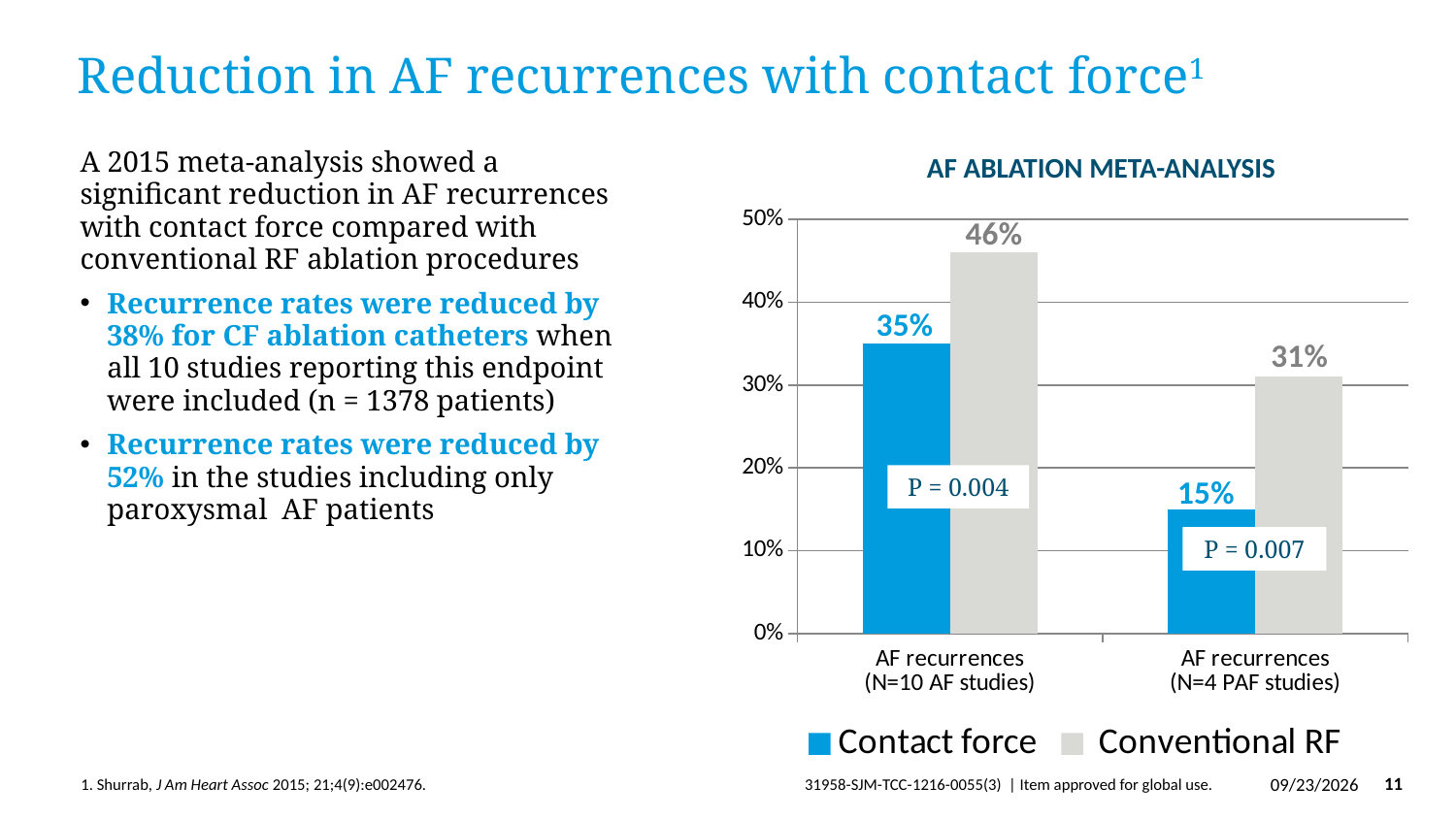
What is the Conventional RF value for AF recurrences (N=10 AF studies)? 46% What is the Conventional RF value for AF recurrences (N=4 PAF studies)? 31% What is the difference between the Conventional RF and Contact force values for AF recurrences (N=10 AF studies)? 11% For AF recurrences (N=4 PAF studies), which is larger: Contact force or Conventional RF? Conventional RF What is the Contact force value for AF recurrences (N=4 PAF studies)? 15% What is the Contact force value for AF recurrences (N=10 AF studies)? 35% What kind of chart is shown on the slide? Bar chart What is the title of the chart? AF ABLATION META-ANALYSIS Which bar in the chart has the lowest value? Contact force, AF recurrences (N=4 PAF studies) Which bar in the chart has the highest value? Conventional RF, AF recurrences (N=10 AF studies) What is the difference between the Conventional RF and Contact force values for AF recurrences (N=4 PAF studies)? 16% How many series does the legend list? 2